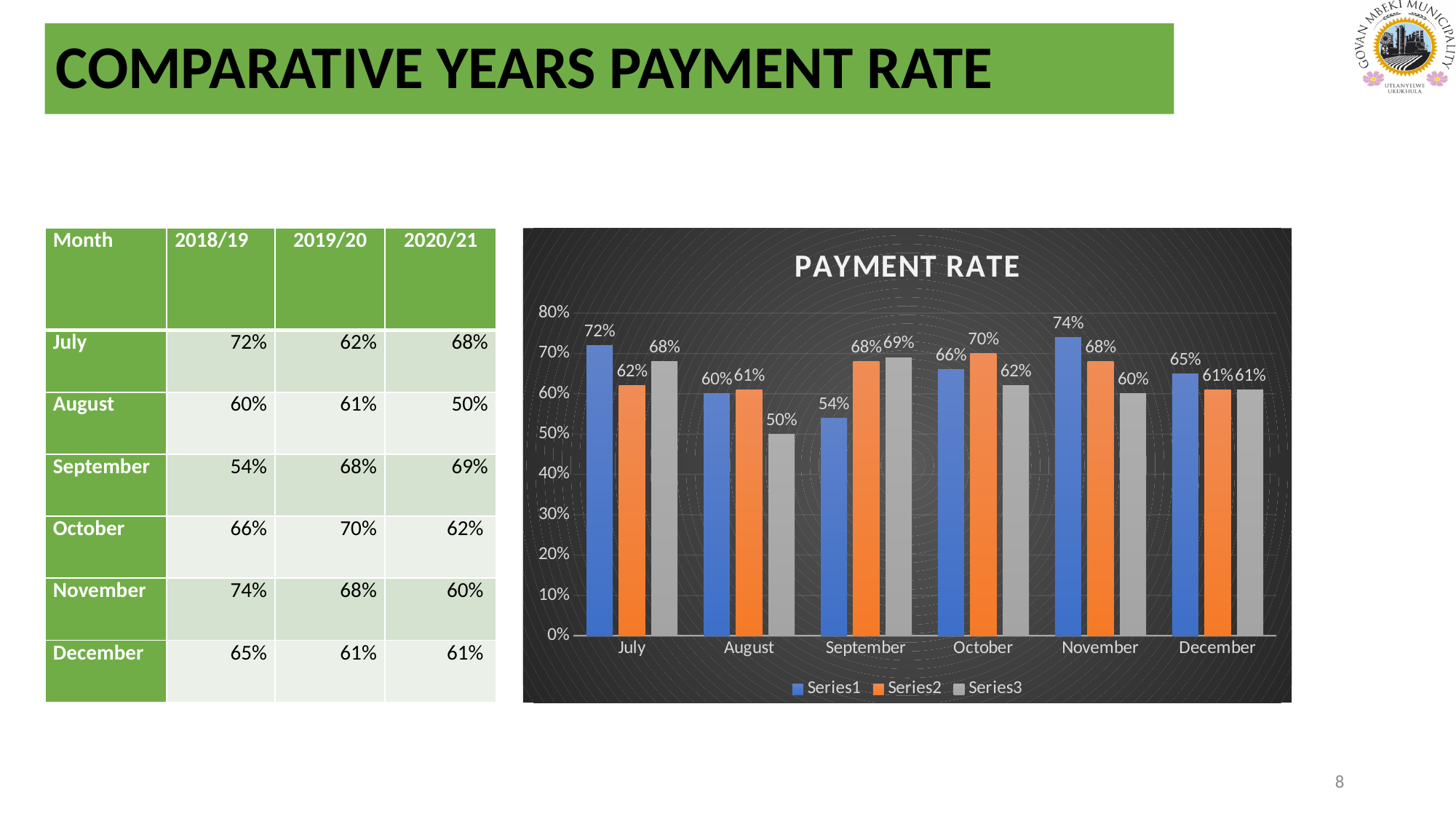
Which month has the lowest Series3 value in the PAYMENT RATE chart? August How many months are shown on the x axis of the PAYMENT RATE chart? 6 What kind of chart is the PAYMENT RATE chart? Bar chart In the PAYMENT RATE chart, which is larger for November: Series1 or Series3? Series1 What is the difference between the Series1 and Series2 values for September in the PAYMENT RATE chart? 14% Is the Series1 value for September in the PAYMENT RATE chart greater or less than 60%? less How many series does the legend of the PAYMENT RATE chart list? 3 What colour are the Series2 bars in the PAYMENT RATE chart? Orange Which month has the highest Series1 value in the PAYMENT RATE chart? November What is the Series1 value for July in the PAYMENT RATE chart? 72% What is the Series2 value for October in the PAYMENT RATE chart? 70% What is the Series3 value for August in the PAYMENT RATE chart? 50%